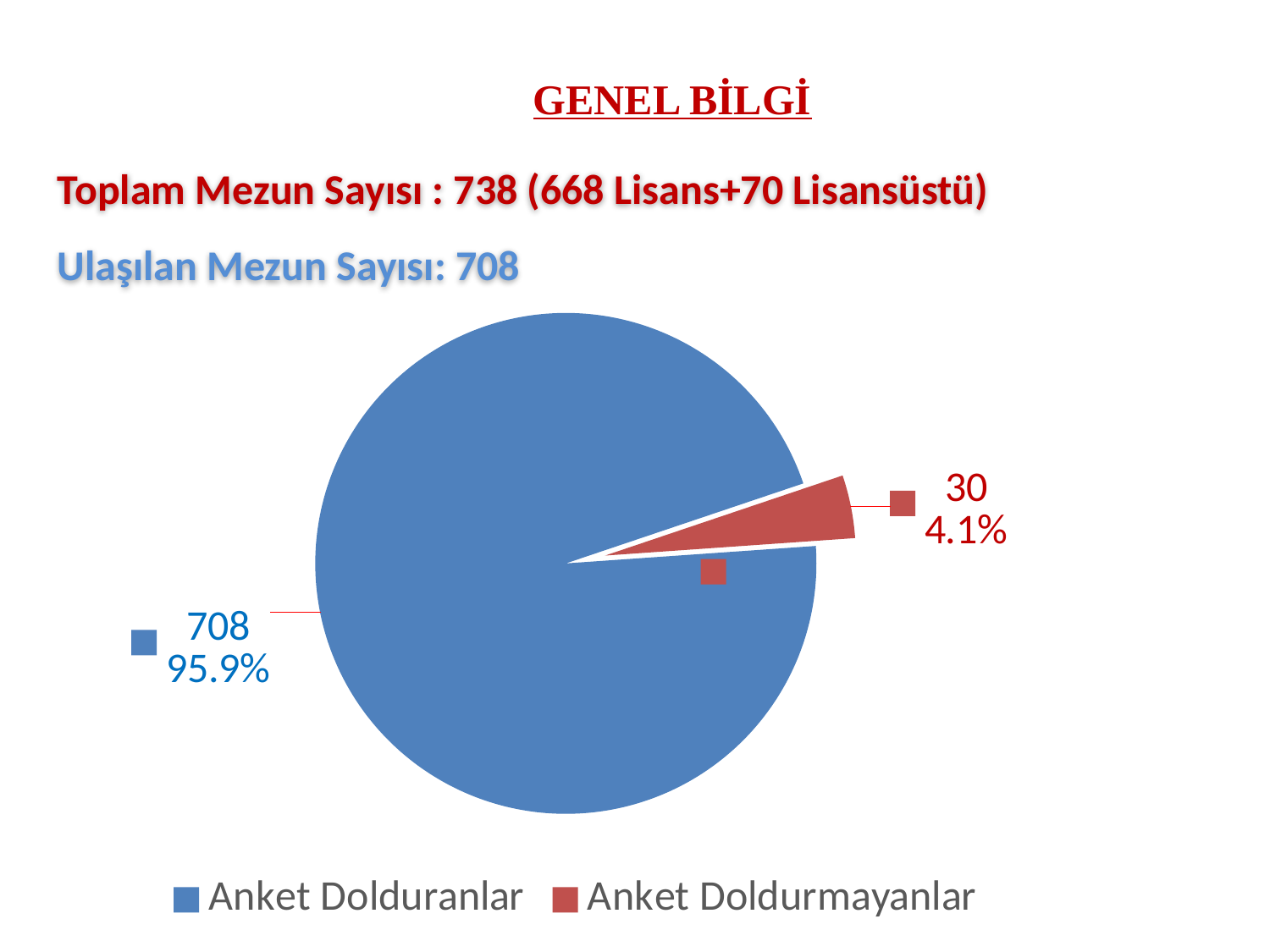
Which slice is the smallest? Anket Doldurmayanlar Which slice is the largest? Anket Dolduranlar What is the value for Anket Dolduranlar? 708 How many slices does the pie chart have? 2 What kind of chart is shown on the slide? pie chart How many entries does the legend list? 2 What is the value for Anket Doldurmayanlar? 30 What share of the pie does Anket Doldurmayanlar represent? 4.1% Which is larger, Anket Dolduranlar or Anket Doldurmayanlar? Anket Dolduranlar What is the difference between the values for Anket Dolduranlar and Anket Doldurmayanlar? 678 What colour is the Anket Doldurmayanlar slice? red What share of the pie does Anket Dolduranlar represent? 95.9%